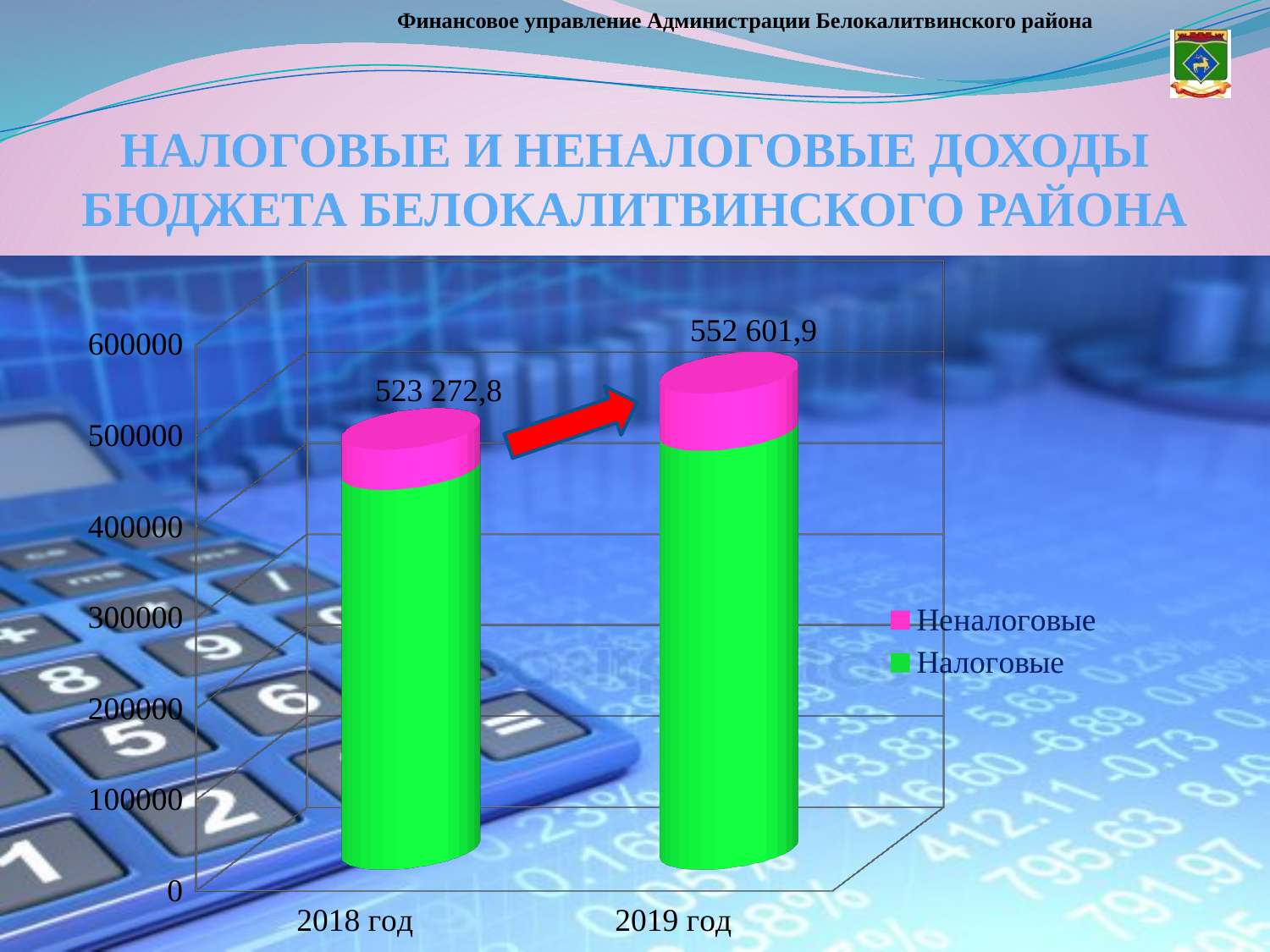
What kind of chart is shown on the slide? Stacked bar chart What is the total labelled on the bar for 2019 год? 552 601,9 Which year has the higher total, 2018 год or 2019 год? 2019 год How many series does the legend list? 2 Is the total for 2019 год greater or less than 600000? less Do the totals rise or fall from 2018 год to 2019 год? Rise Which category has the lowest total? 2018 год What is the total labelled on the bar for 2018 год? 523 272,8 What is the difference between the totals for 2019 год and 2018 год? 29 329,1 Which series is larger in the 2018 год bar, Налоговые or Неналоговые? Налоговые How many categories are shown on the x axis? 2